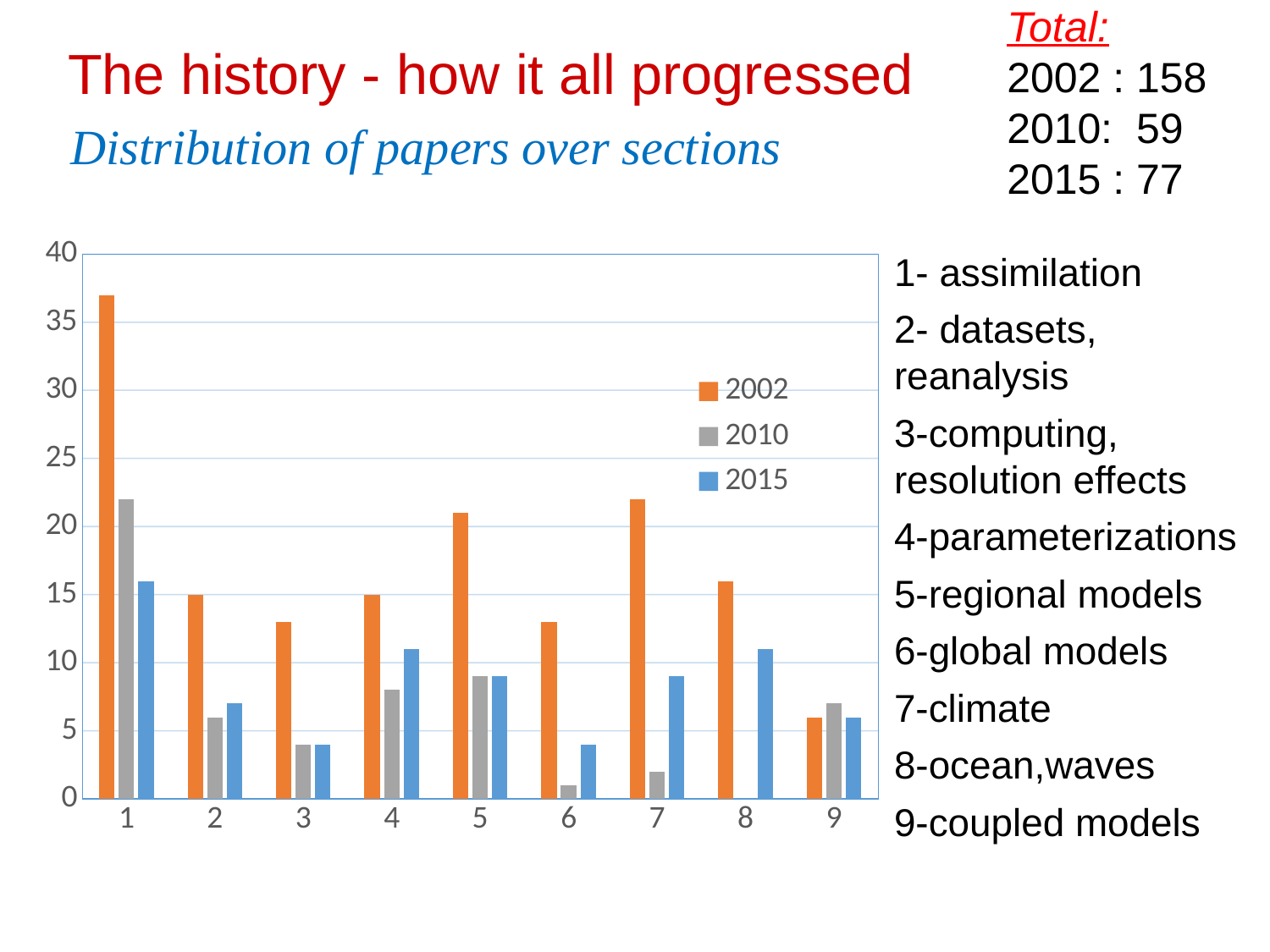
Is the 2002 value for section 9 greater or less than 10? less Is the 2002 value for section 1 greater or less than 35? greater For section 1, which series has the larger value, 2002 or 2015? 2002 How many sections (categories) are shown along the x axis of the chart? 9 What kind of chart is shown on the slide? bar chart What is the 2002 value for section 2? 15 Is the 2010 value for section 1 greater or less than 20? greater What are the entries listed in the chart legend? 2002, 2010, 2015 Which section has the highest value for the 2002 series? 1 Which section has the lowest value for the 2010 series? 8 How many series does the chart legend list? 3